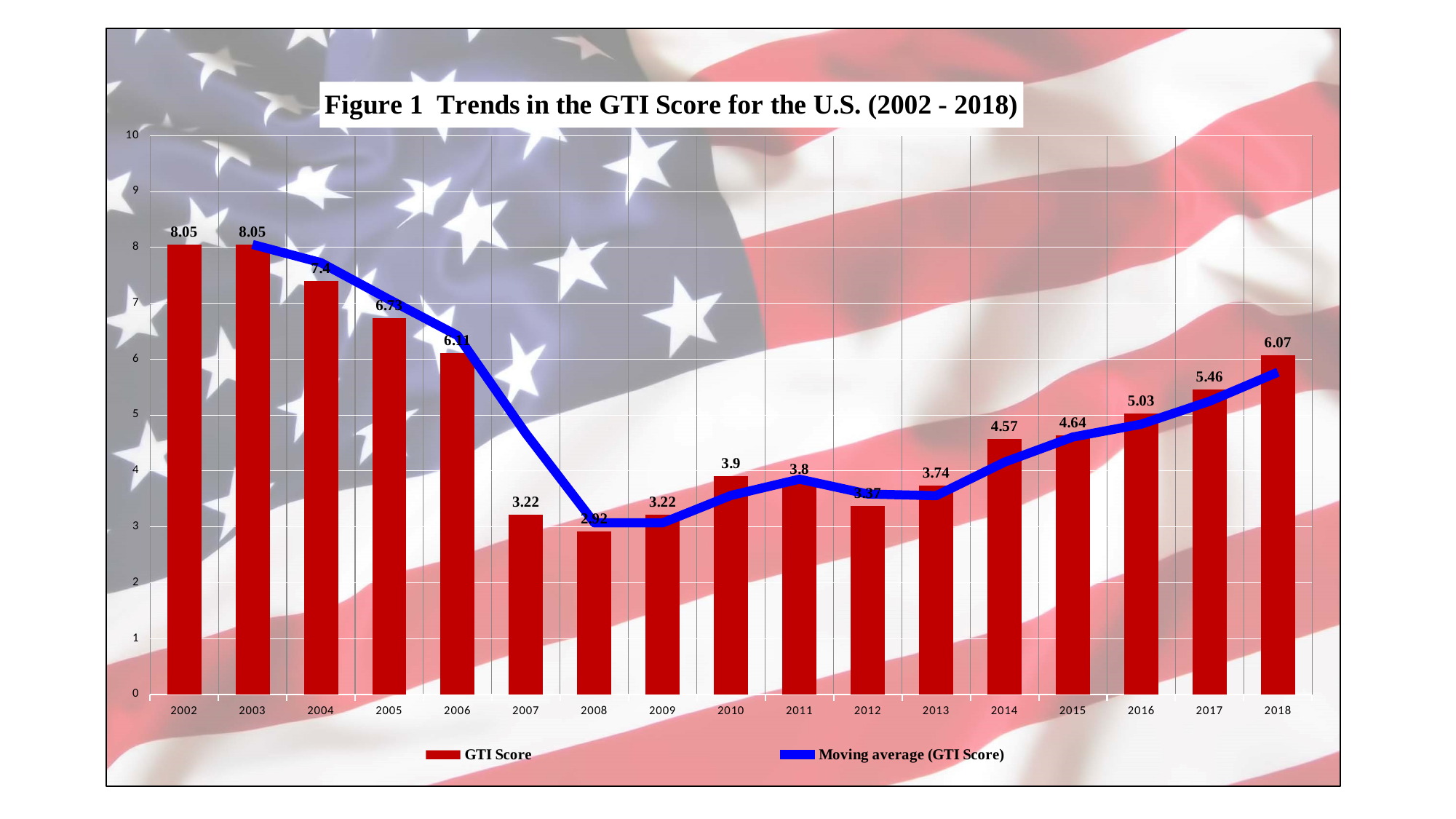
Which year has a higher GTI Score, 2014 or 2015? 2015 How many series does the legend list? 2 What is the GTI Score for the U.S. in 2018? 6.07 Is the GTI Score for 2012 greater or less than 4? less What is the difference between the GTI Score in 2016 and in 2014? 0.46 Which year has the lowest GTI Score? 2008 What is the GTI Score for 2010? 3.9 What is the highest GTI Score value shown on the chart? 8.05 How many years are shown on the x axis? 17 What is the GTI Score for 2004? 7.4 Does the GTI Score rise or fall from 2014 to 2018? rise What is the difference between the GTI Score in 2018 and in 2017? 0.61